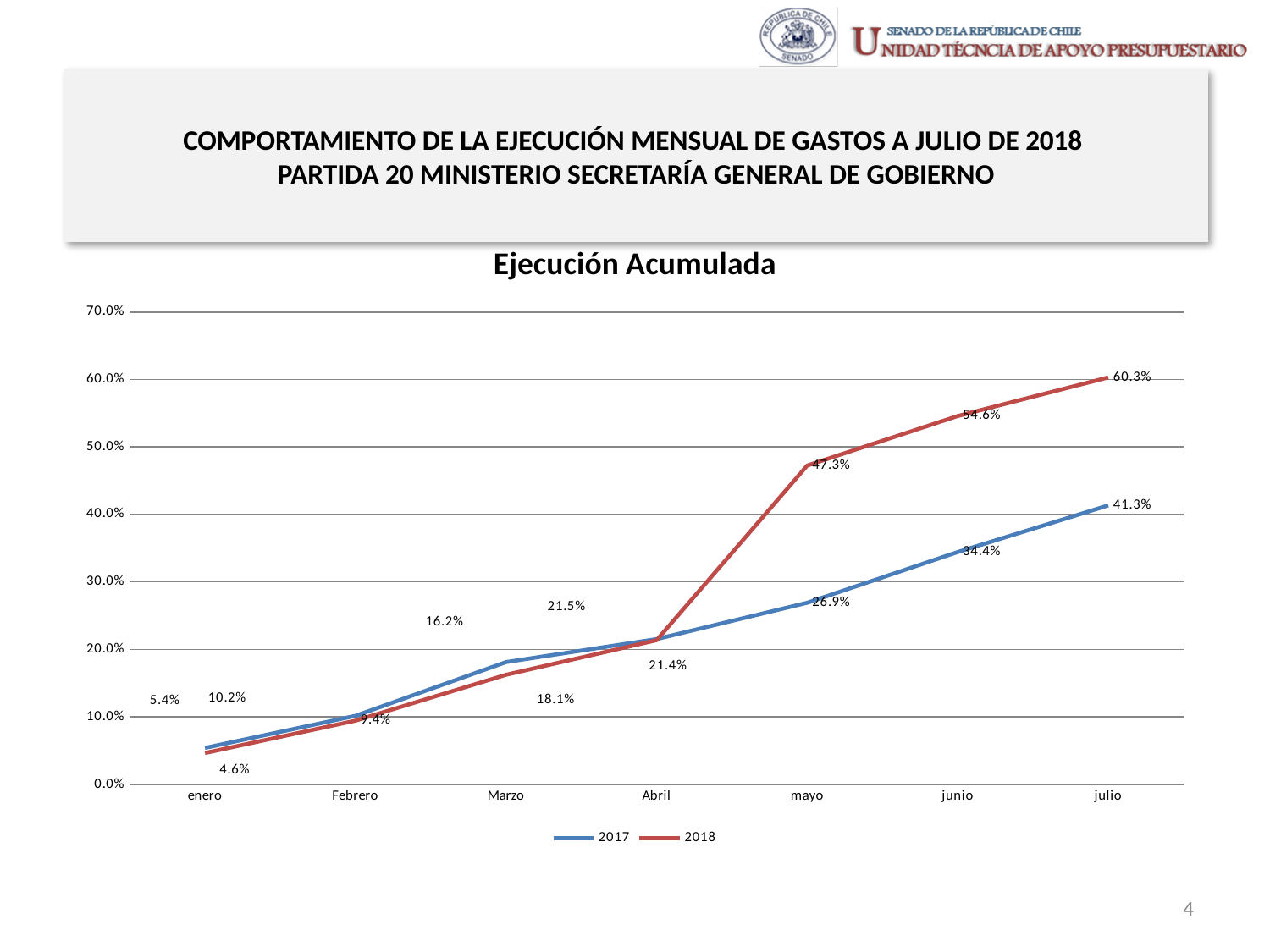
What is the difference between the 2018 and 2017 values in julio? 19.0% What is the value for 2017 in julio? 41.3% What is the value for 2018 in julio? 60.3% In mayo, which series has the larger value, 2017 or 2018? 2018 What is the title of the chart? Ejecución Acumulada What kind of chart is shown on the slide? line chart How many series does the legend list? 2 What is the value for 2018 in mayo? 47.3% In which month does the 2018 series reach its highest value? julio Does the 2018 line rise or fall from enero to julio? rises How many months are plotted along the x axis? 7 What is the value for 2017 in junio? 34.4%